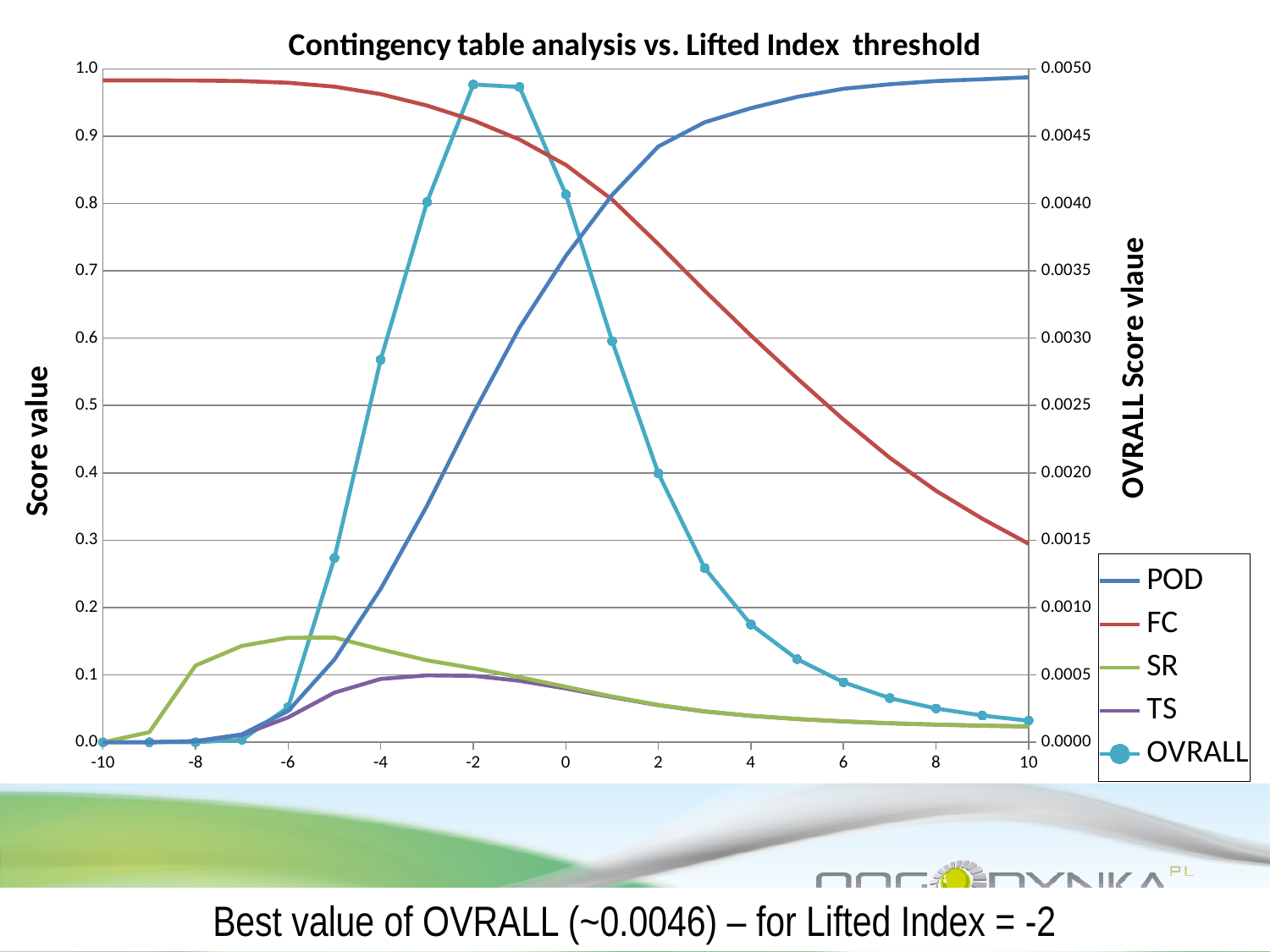
What kind of chart is shown on the slide? line chart Does the POD series rise or fall as the Lifted Index increases from -10 to 10? rise Is the value of SR at Lifted Index -5 greater or less than 0.2? less At Lifted Index -10, which series is larger, FC or POD? FC Does the FC series rise or fall as the Lifted Index increases from -10 to 10? fall At which Lifted Index value does the OVRALL series reach its best (highest) value? -2 What is the title of the chart? Contingency table analysis vs. Lifted Index threshold Is the value of POD at Lifted Index 10 greater or less than 0.9? greater How many data points (markers) are plotted for the OVRALL series? 21 What is the label of the right-hand vertical axis? OVRALL Score vlaue How many series does the legend list? 5 Is the value of OVRALL at Lifted Index 2 greater or less than 0.0025? less